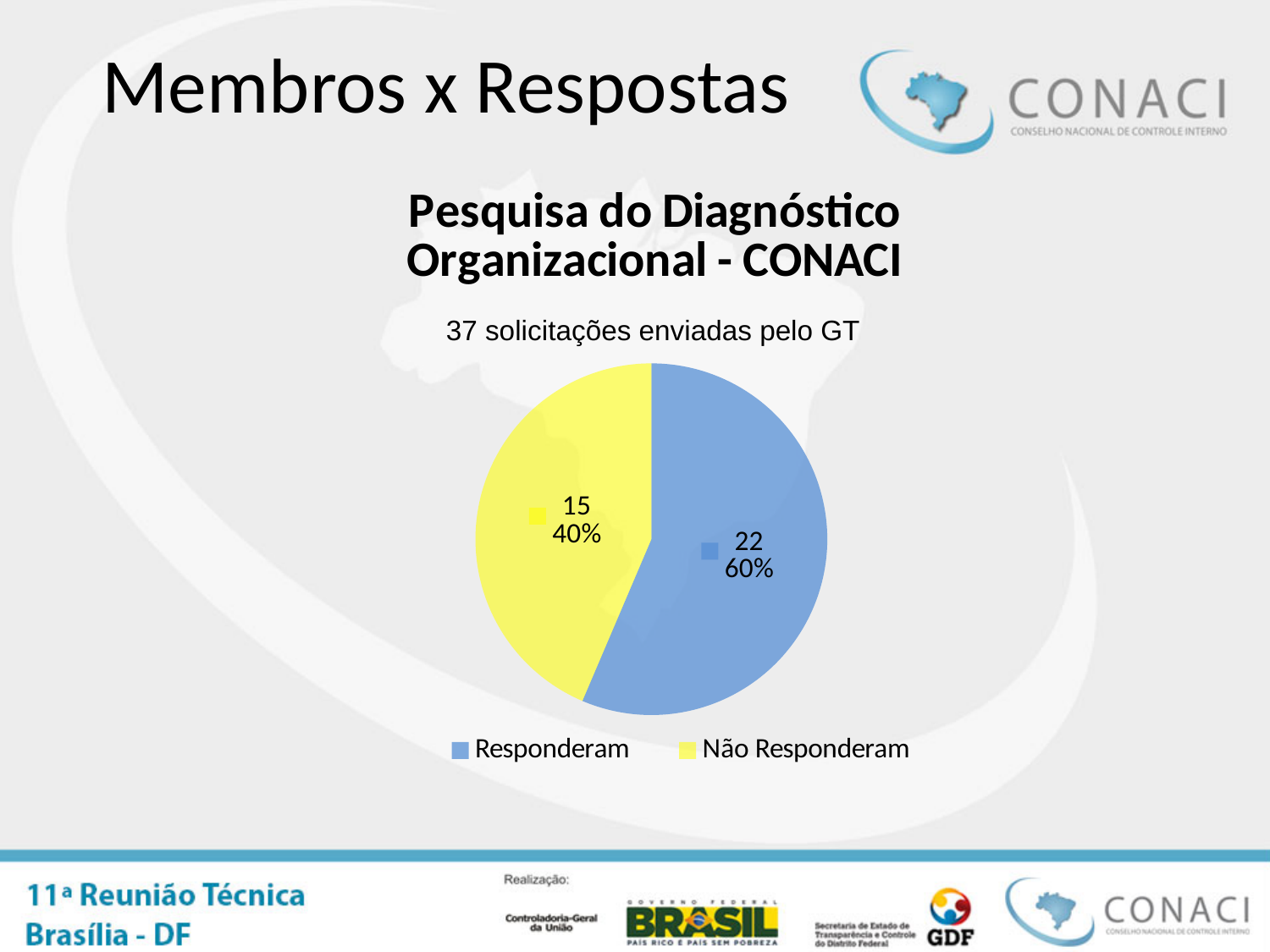
What is the difference between the values for Responderam and Não Responderam? 7 How many slices does the pie chart have? 2 Which slice of the pie chart is the largest? Responderam What kind of chart is shown on the slide? pie chart What is the value for Responderam in the pie chart? 22 What is the title of the pie chart? Pesquisa do Diagnóstico Organizacional - CONACI What share of the pie does Responderam represent? 60% What share of the pie does Não Responderam represent? 40% Which is larger, Responderam or Não Responderam? Responderam How many entries does the legend of the pie chart list? 2 What is the value for Não Responderam in the pie chart? 15 Which slice of the pie chart is the smallest? Não Responderam